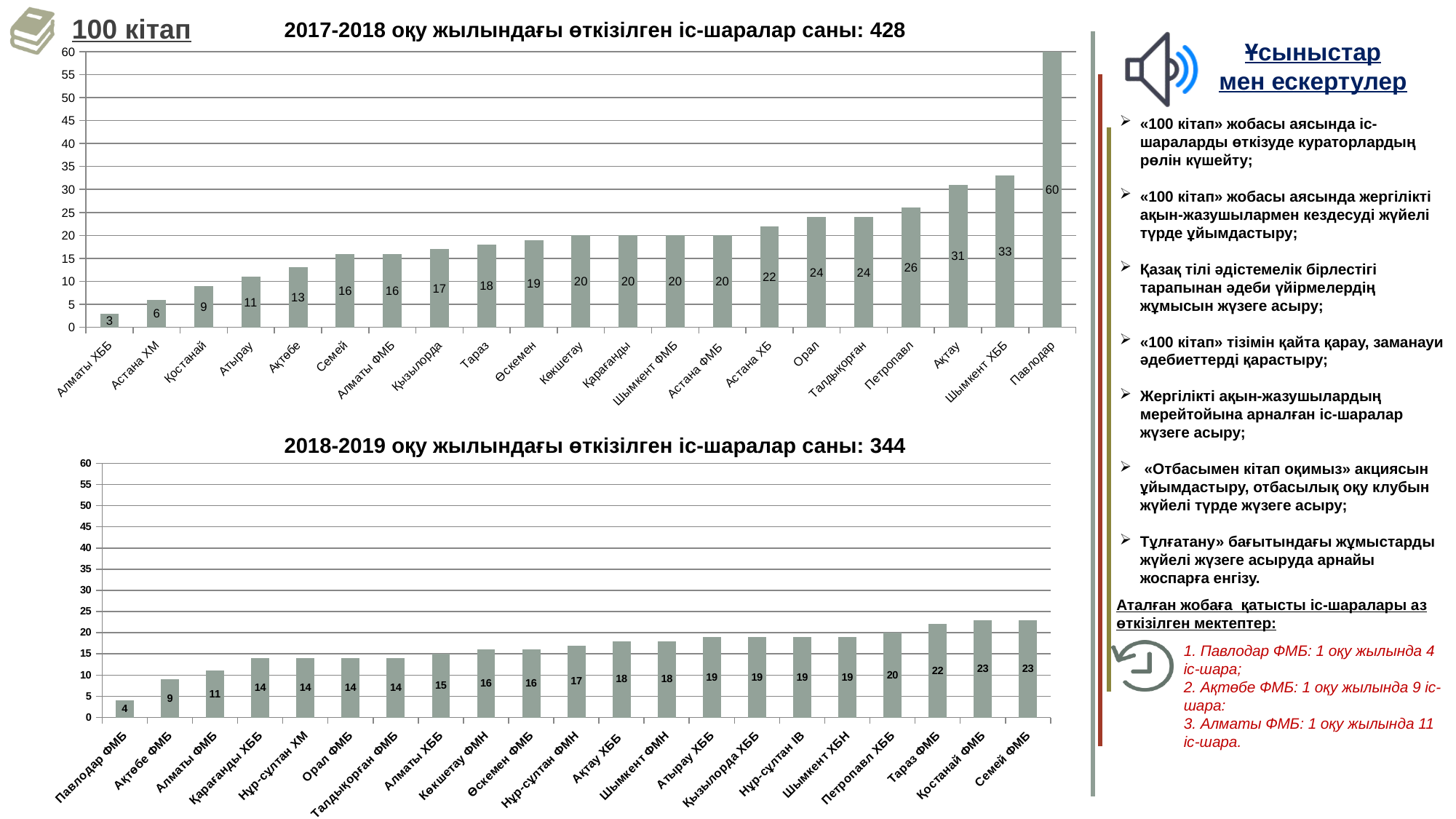
In the 2017-2018 chart, what is the difference between Шымкент ХББ and Петропавл? 7 In the 2017-2018 chart, which is larger: Орал or Астана ХБ? Орал In the 2018-2019 chart, which category has the lowest value? Павлодар ФМБ In the 2017-2018 chart, what is the value for Павлодар? 60 In the 2018-2019 chart, which is larger: Тараз ФМБ or Алматы ХББ? Тараз ФМБ In the 2018-2019 chart, what is the value for Петропавл ХББ? 20 In the 2017-2018 chart, how many categories are shown? 21 In the 2018-2019 chart, do the values rise or fall from left to right? Rise What kind of chart is the 2018-2019 chart? Bar chart In the 2017-2018 chart, which category has the lowest value? Алматы ХББ In the 2017-2018 chart, what is the value for Ақтау? 31 In the 2018-2019 chart, what is the difference between Семей ФМБ and Ақтөбе ФМБ? 14